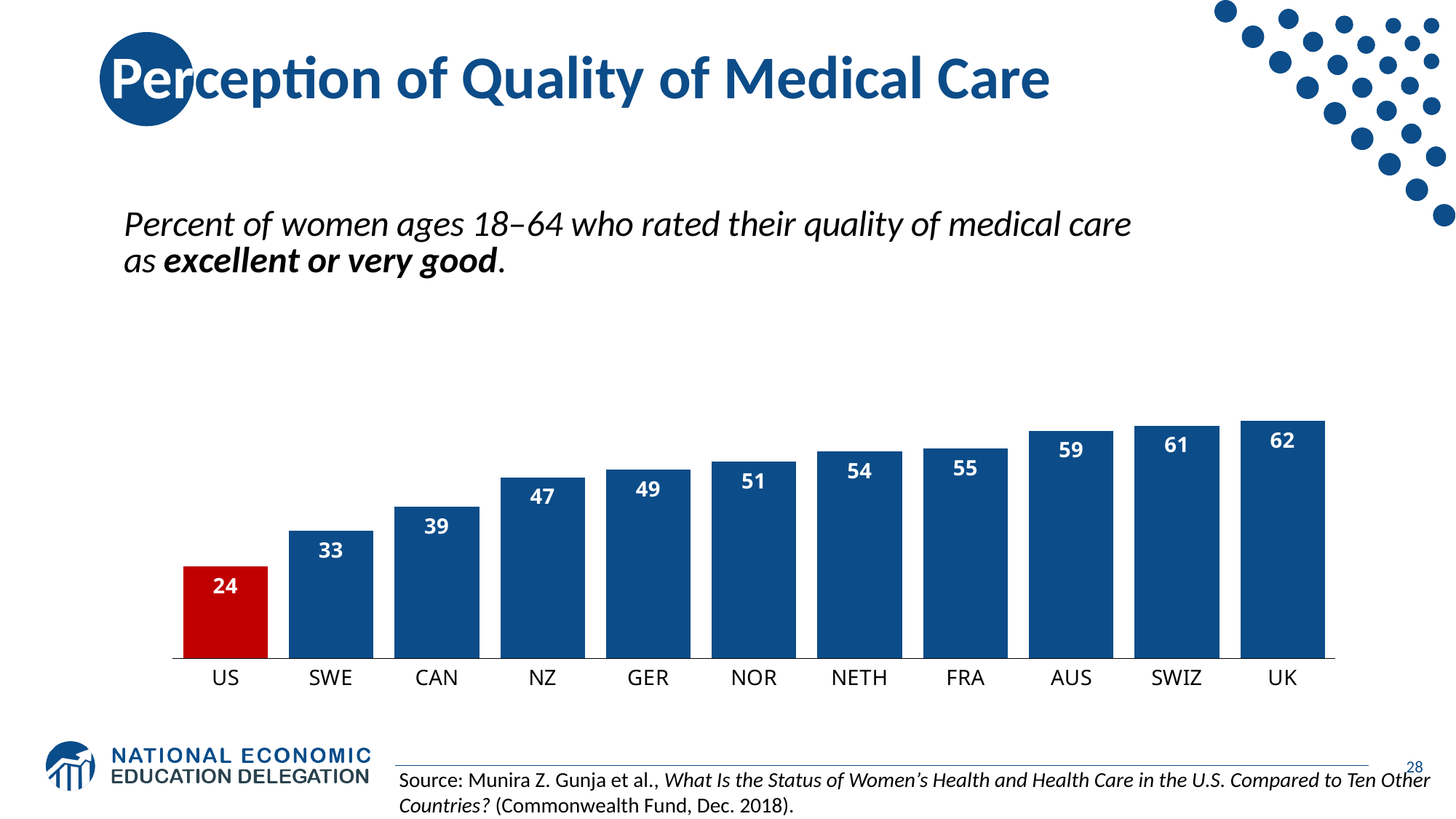
What is the difference between the values for UK and US? 38 Which bar is coloured red rather than blue? US Which country has the highest value? UK What kind of chart is shown on the slide? bar chart What is the difference between the values for NETH and CAN? 15 How many countries are shown in the chart? 11 Do the values rise or fall from left to right along the x axis? rise Which country has the lowest value? US What is the value for AUS? 59 Which is larger, the value for SWE or the value for NZ? NZ What is the value for GER? 49 What is the value for the US? 24